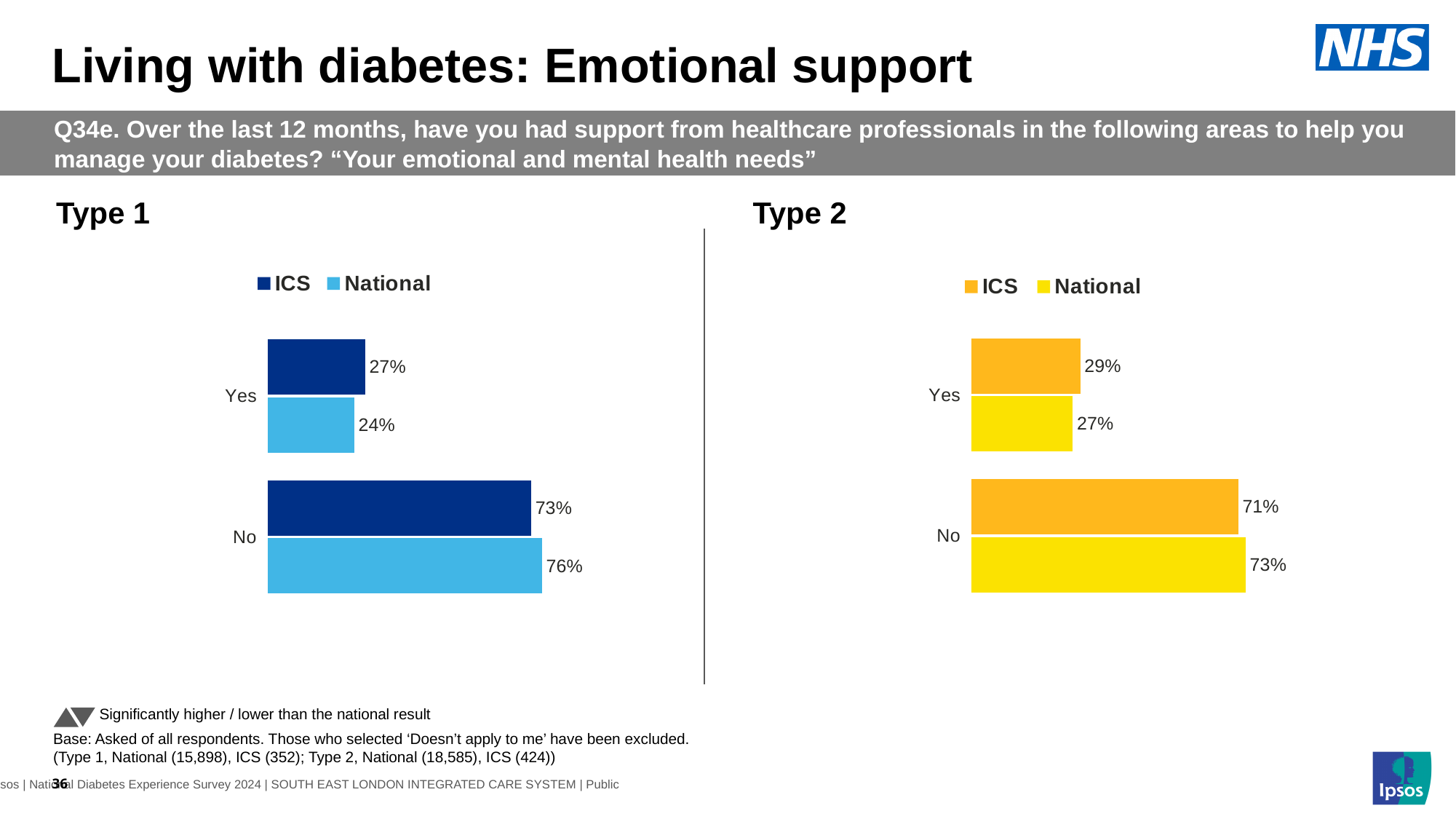
In the Type 1 chart, what is the difference between the National and ICS values for No? 3% In the Type 1 chart, what is the National value for No? 76% In the Type 1 chart, what is the ICS value for Yes? 27% In the Type 2 chart, what is the National value for No? 73% In the Type 2 chart, which is larger for No: ICS or National? National In the Type 2 chart, which category has the lowest National value? Yes How many series does the legend of the Type 2 chart list? 2 In the Type 1 chart, which series has the highest value overall? National (No, 76%) What kind of chart is the Type 1 chart? Bar chart In the Type 2 chart, what is the difference between the ICS and National values for Yes? 2% In the Type 2 chart, what is the ICS value for Yes? 29% In the Type 1 chart, which is larger for Yes: ICS or National? ICS